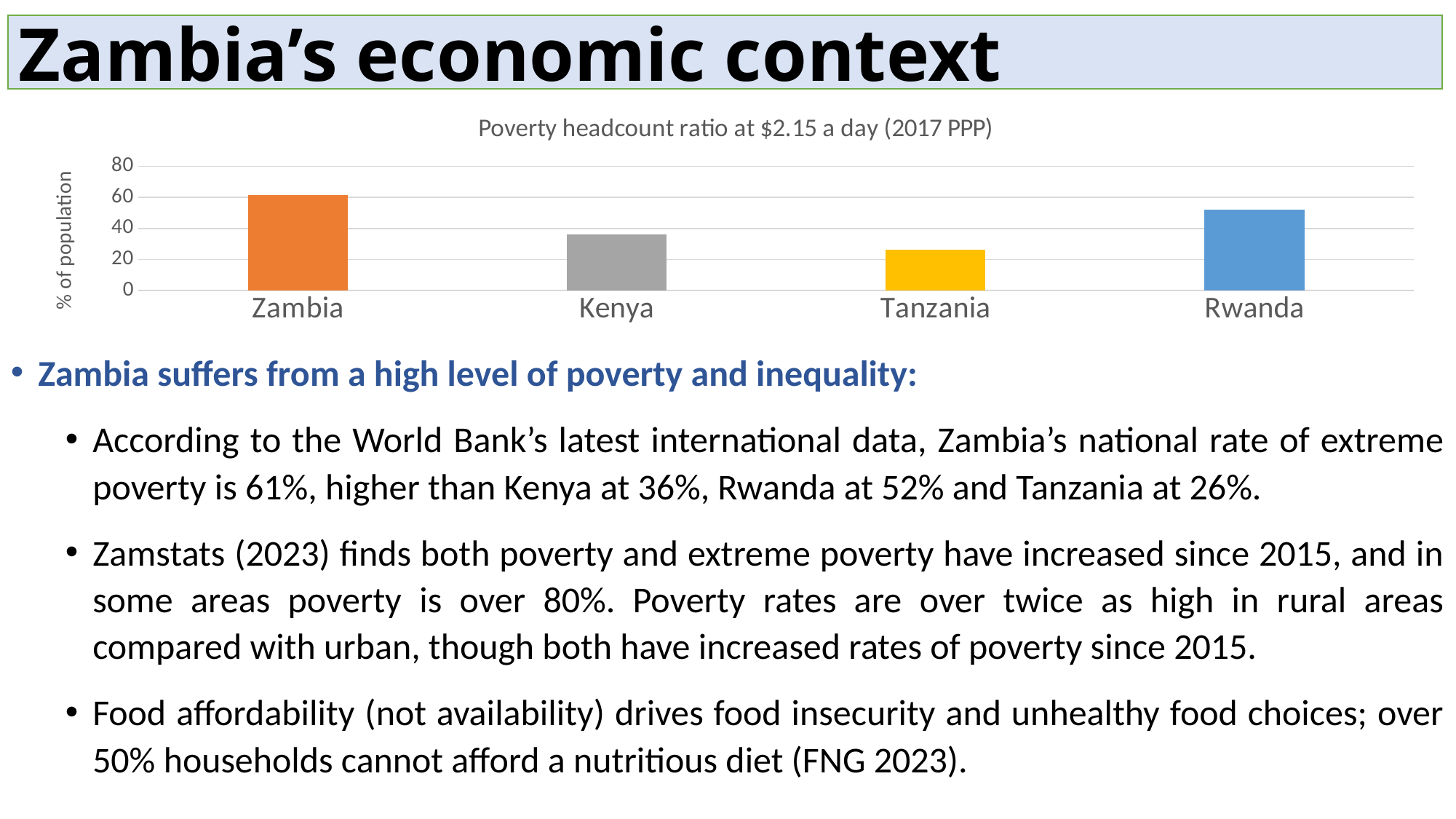
Is the value for Kenya greater or less than 20? greater Which country has the highest poverty headcount ratio in the chart? Zambia How many countries are shown in the chart? 4 What is the title of the chart? Poverty headcount ratio at $2.15 a day (2017 PPP) Which has a lower poverty headcount ratio, Tanzania or Kenya? Tanzania What is the label on the vertical axis of the chart? % of population Which has a higher poverty headcount ratio, Kenya or Rwanda? Rwanda What kind of chart is shown on the slide? bar chart Is the value for Rwanda greater or less than 60? less Is the value for Zambia greater or less than 40? greater Which country has the lowest poverty headcount ratio in the chart? Tanzania